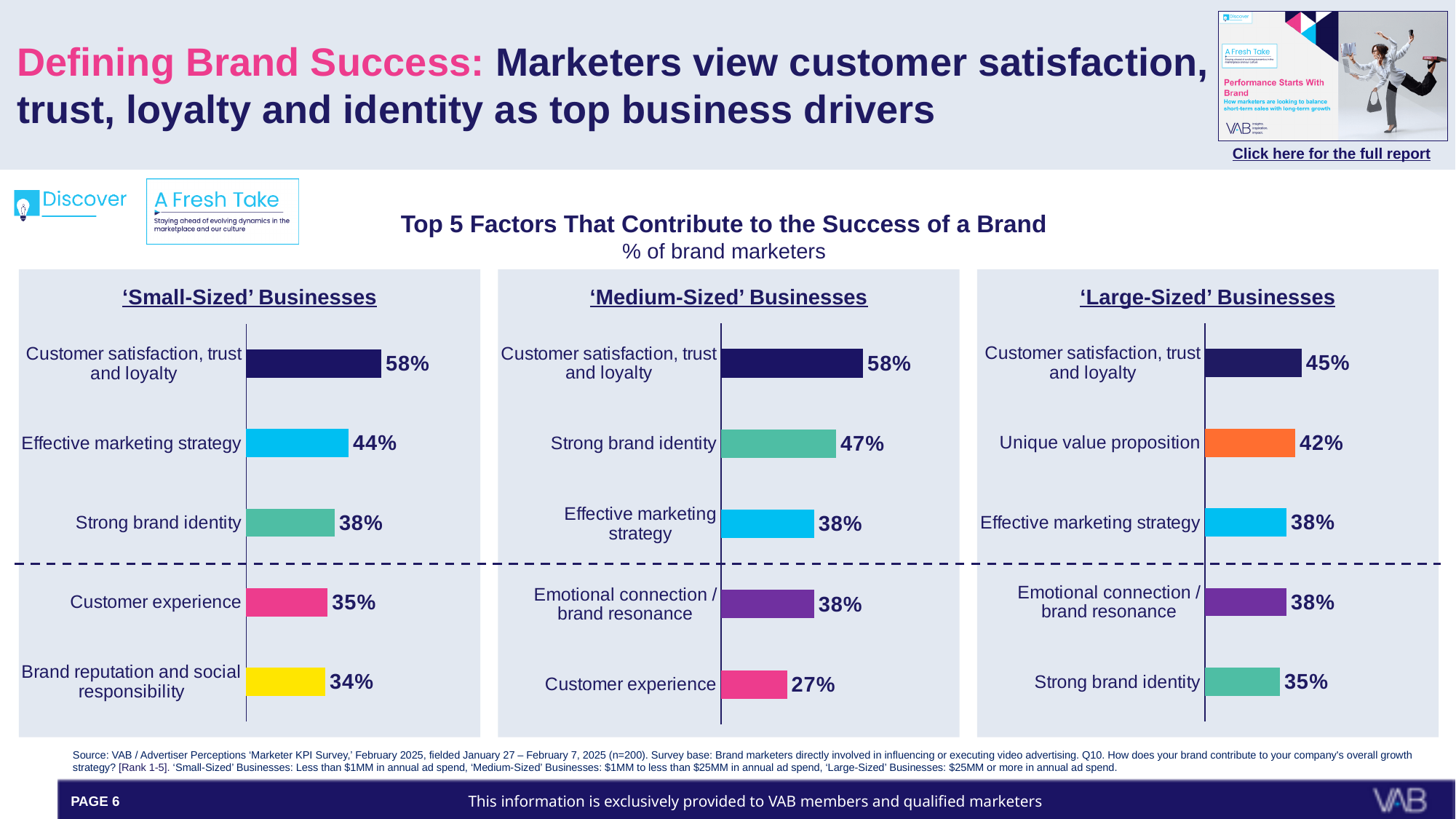
In the 'Small-Sized' Businesses chart, what is the difference between Customer satisfaction, trust and loyalty and Brand reputation and social responsibility? 24 percentage points What is the title shown above the three charts? Top 5 Factors That Contribute to the Success of a Brand In the 'Small-Sized' Businesses chart, what percentage of brand marketers cited Effective marketing strategy? 44% In the 'Large-Sized' Businesses chart, which factor has the highest percentage? Customer satisfaction, trust and loyalty In the 'Large-Sized' Businesses chart, what percentage of brand marketers cited Unique value proposition? 42% In the 'Medium-Sized' Businesses chart, what percentage of brand marketers cited Emotional connection / brand resonance? 38% In the 'Large-Sized' Businesses chart, what is the difference between Unique value proposition and Strong brand identity? 7 percentage points How many factors are shown in the 'Small-Sized' Businesses chart? 5 Which is larger: Customer satisfaction, trust and loyalty in the 'Medium-Sized' Businesses chart or in the 'Large-Sized' Businesses chart? 'Medium-Sized' Businesses In the 'Medium-Sized' Businesses chart, which factor has the lowest percentage? Customer experience What type of chart is used for the 'Medium-Sized' Businesses data? Bar chart In the 'Medium-Sized' Businesses chart, what percentage of brand marketers cited Strong brand identity? 47%